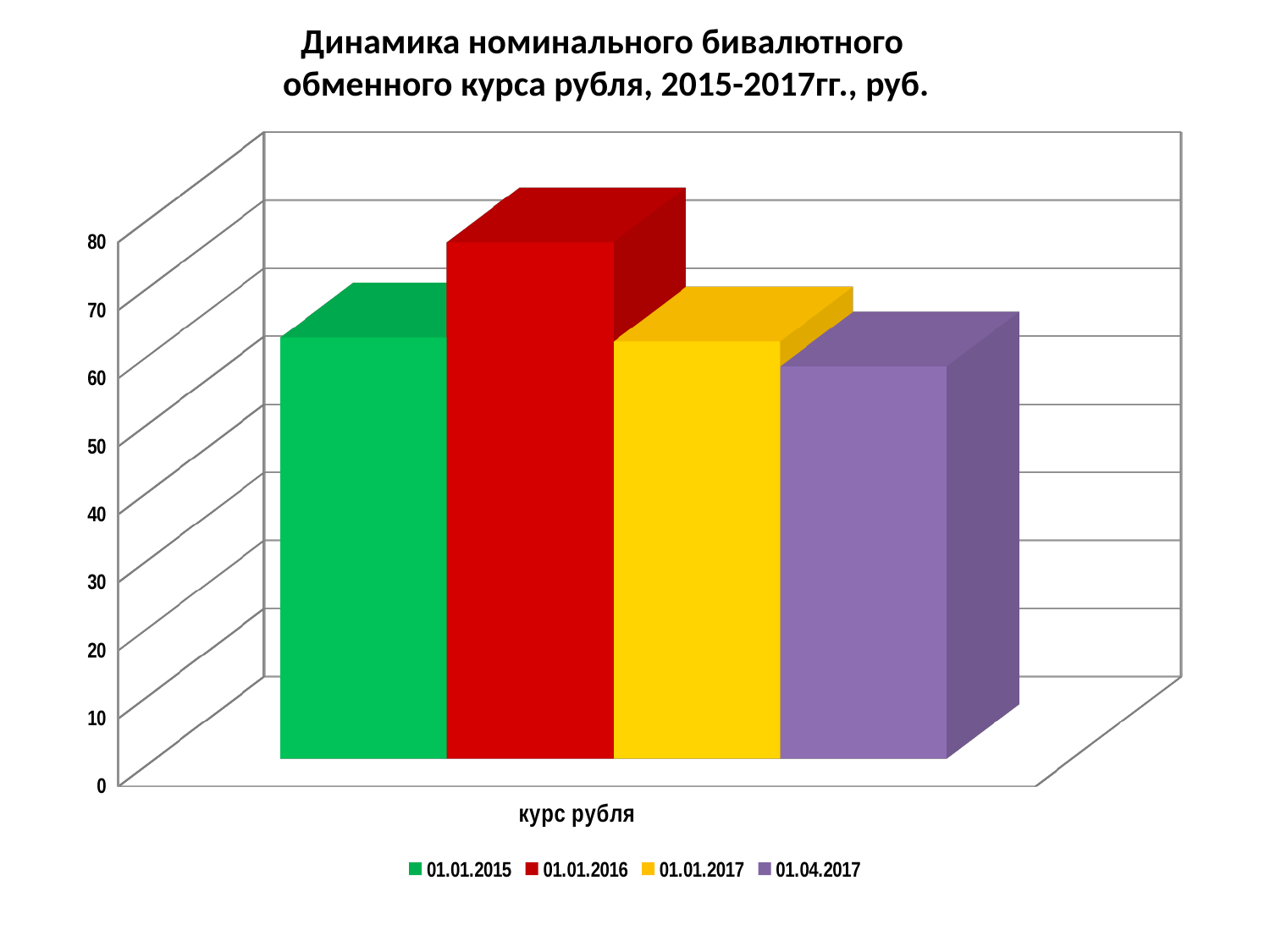
Which date has the lowest value for курс рубля? 01.04.2017 Which date has the highest value for курс рубля? 01.01.2016 Is the value for 01.04.2017 greater or less than 70? less How many series does the legend list? 4 What colour is the bar for 01.01.2016? red Which is larger, the value for 01.01.2015 or the value for 01.04.2017? 01.01.2015 Is the value for 01.01.2017 greater or less than 70? less What kind of chart is shown on the slide? bar chart Is the value for 01.01.2016 greater or less than 70? greater How many categories are shown on the x axis? 1 Which is larger, the value for 01.01.2016 or the value for 01.04.2017? 01.01.2016